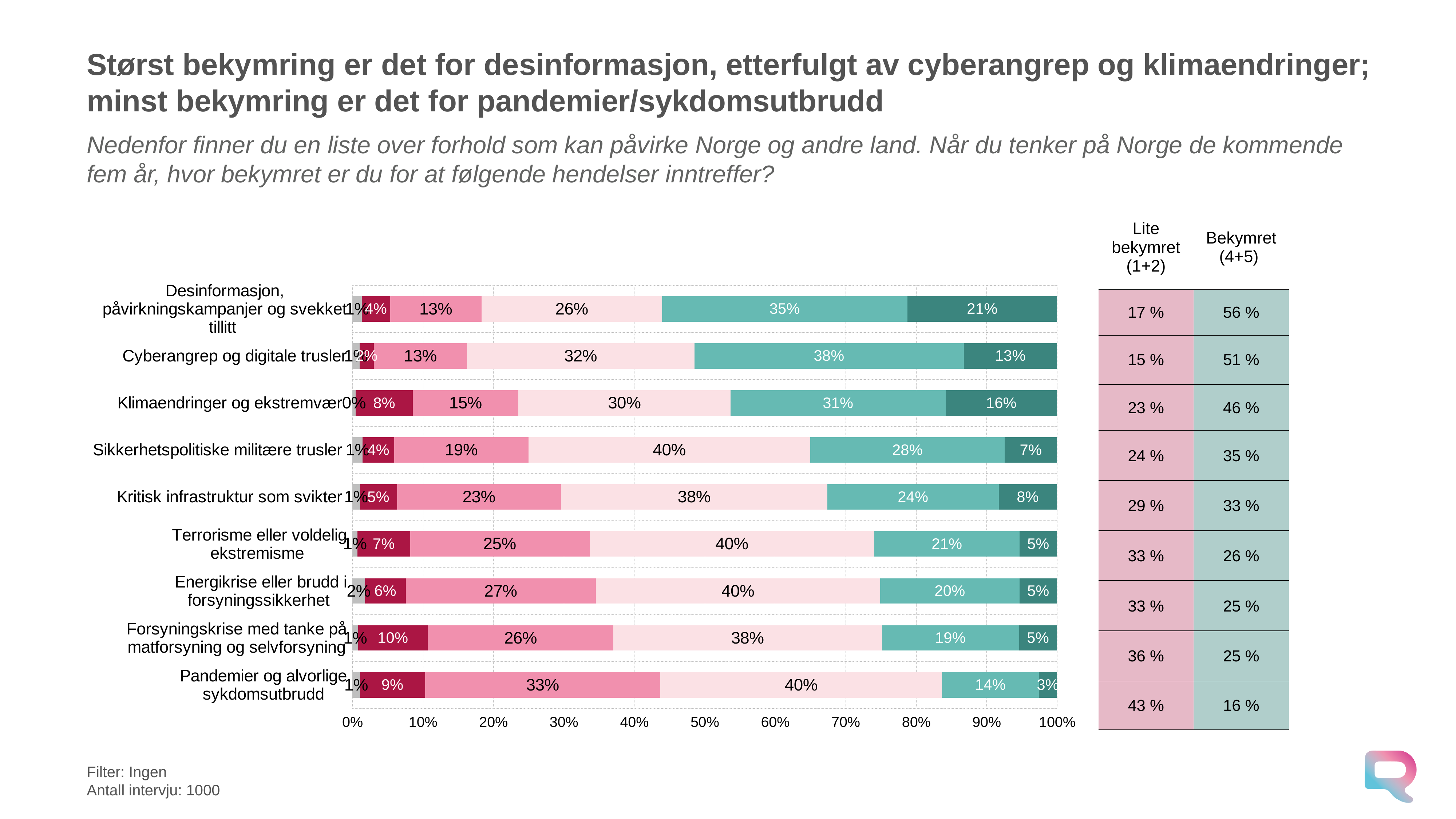
What is the value of the rightmost dark teal segment for "Desinformasjon, påvirkningskampanjer og svekket tillitt"? 21% What is the difference between the teal segment for "Cyberangrep og digitale trusler" (38%) and the teal segment for "Desinformasjon, påvirkningskampanjer og svekket tillitt" (35%)? 3 percentage points In the table to the right of the chart, which category has the highest "Lite bekymret (1+2)" value? Pandemier og alvorlige sykdomsutbrudd In the table to the right of the chart, what is the "Bekymret (4+5)" value for "Desinformasjon, påvirkningskampanjer og svekket tillitt"? 56 % Which has the larger dark red segment: "Klimaendringer og ekstremvær" or "Pandemier og alvorlige sykdomsutbrudd"? Pandemier og alvorlige sykdomsutbrudd Which category has the largest rightmost dark teal segment? Desinformasjon, påvirkningskampanjer og svekket tillitt What is the value of the pink segment (second from left after the dark red one) for "Pandemier og alvorlige sykdomsutbrudd"? 33% What is the value of the light pink middle segment for "Cyberangrep og digitale trusler"? 32% What is the value of the light pink middle segment for "Sikkerhetspolitiske militære trusler"? 40% How many categories (rows) does the bar chart show? 9 What kind of chart is shown on the slide? bar chart Which category has the smallest rightmost dark teal segment? Pandemier og alvorlige sykdomsutbrudd